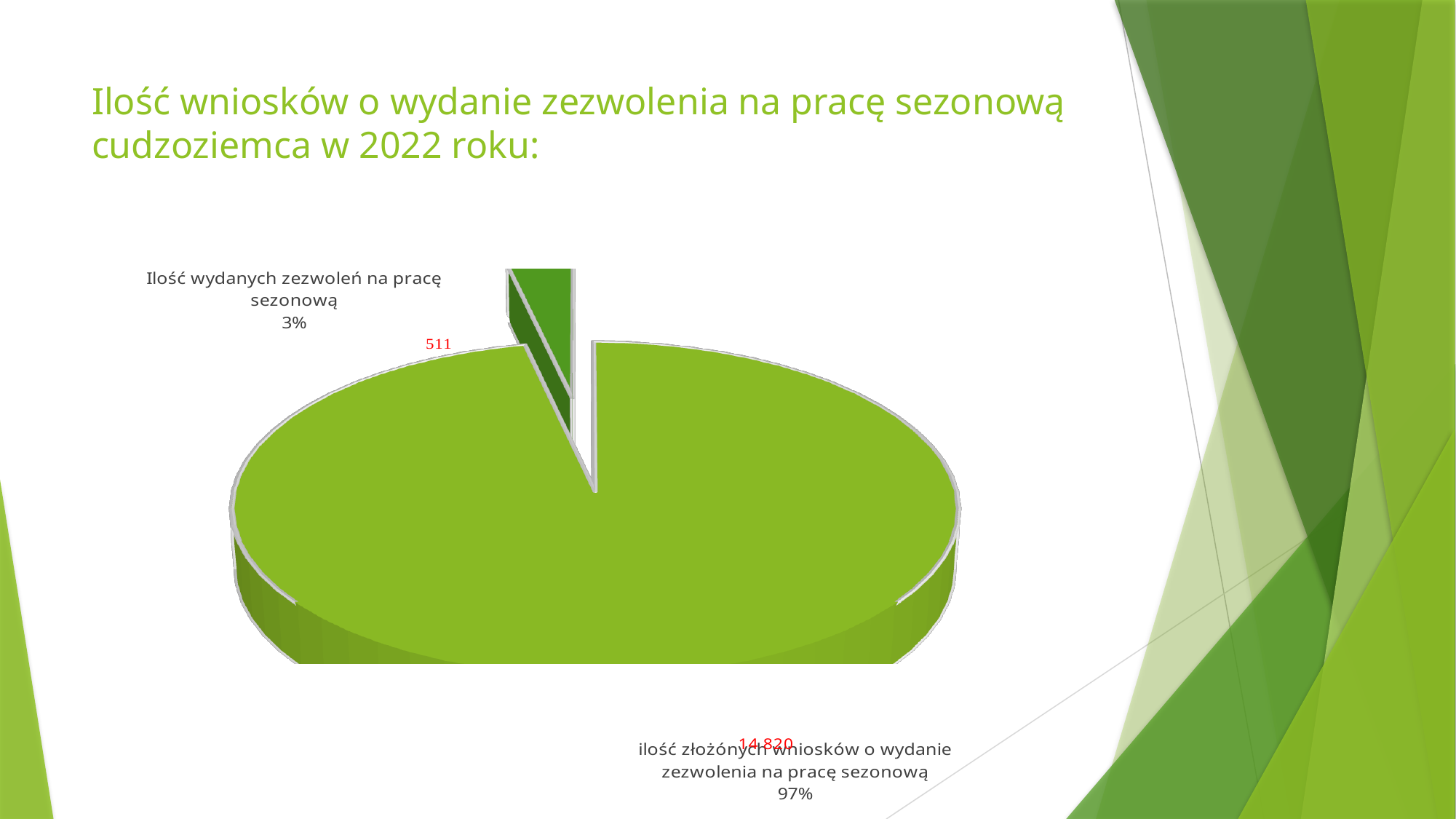
Which is larger: the share for "Ilość wydanych zezwoleń na pracę sezonową" or the share for "ilość złożonych wniosków o wydanie zezwolenia na pracę sezonową"? ilość złożonych wniosków o wydanie zezwolenia na pracę sezonową What kind of chart is shown on the slide? Pie chart What is the value shown for "ilość złożonych wniosków o wydanie zezwolenia na pracę sezonową"? 14 820 Which slice of the pie chart is the largest? ilość złożonych wniosków o wydanie zezwolenia na pracę sezonową How many slices does the pie chart have? 2 In what colour are the numeric data values (511 and 14 820) printed on the pie chart? Red What share of the pie does "Ilość wydanych zezwoleń na pracę sezonową" represent? 3% What is the value shown for "Ilość wydanych zezwoleń na pracę sezonową"? 511 What share of the pie does "ilość złożonych wniosków o wydanie zezwolenia na pracę sezonową" represent? 97% Which slice of the pie chart is the smallest? Ilość wydanych zezwoleń na pracę sezonową What is the difference in percentage points between the two slices of the pie chart? 94 percentage points What is the title of the slide containing the pie chart? Ilość wniosków o wydanie zezwolenia na pracę sezonową cudzoziemca w 2022 roku: